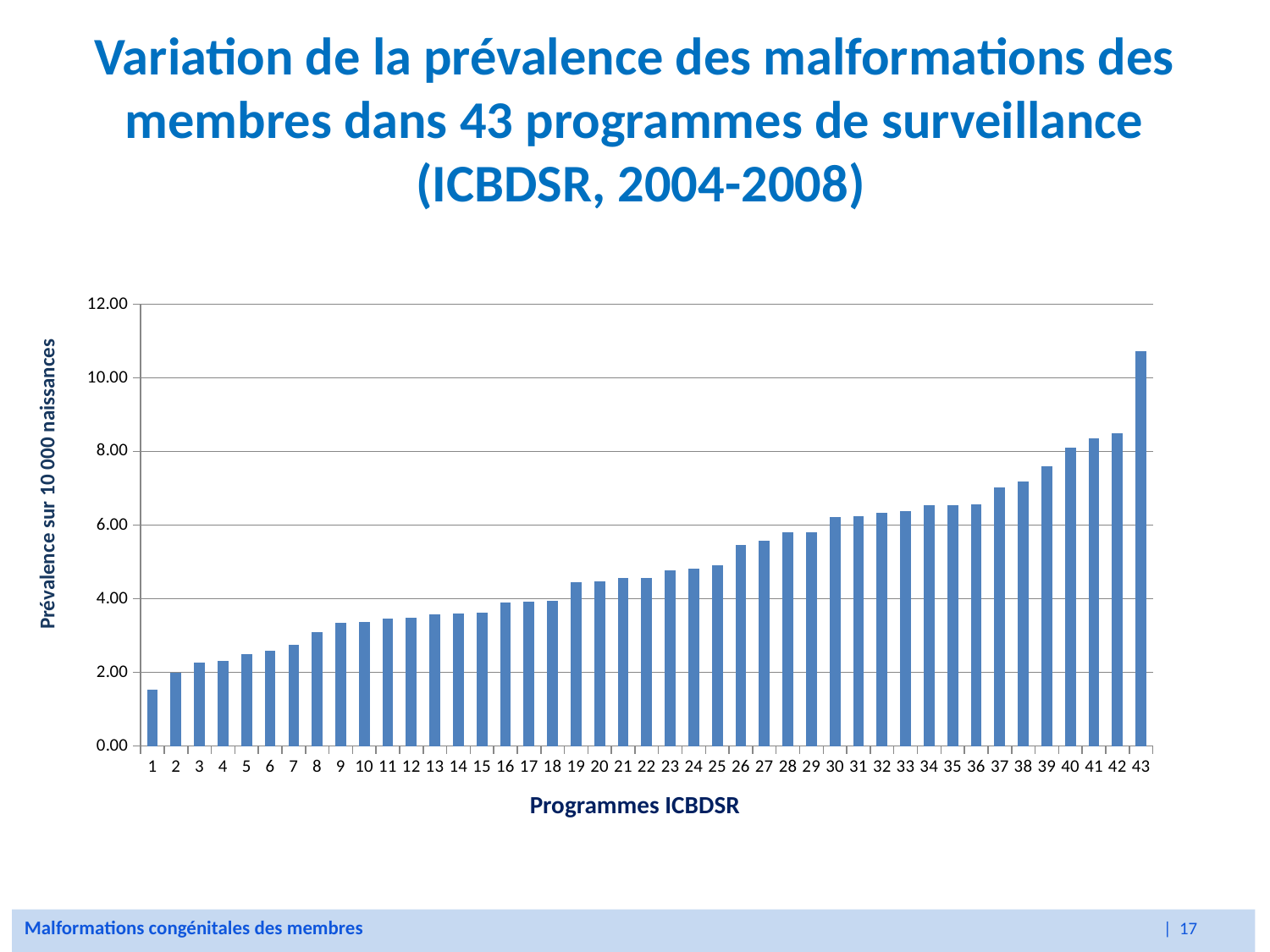
Is the value for programme 43 greater or less than 10.00? greater Which programme has the lowest prevalence? 1 How many programmes (bars) are plotted on the x axis? 43 Is the value for programme 39 greater or less than 8.00? less What is the label of the y axis? Prévalence sur 10 000 naissances Which has the larger value, programme 10 or programme 30? 30 Is the value for programme 20 greater or less than 4.00? greater What is the label of the x axis? Programmes ICBDSR Which programme has the highest prevalence? 43 Do the values rise or fall from programme 1 to programme 43? rise What kind of chart is shown on the slide? bar chart